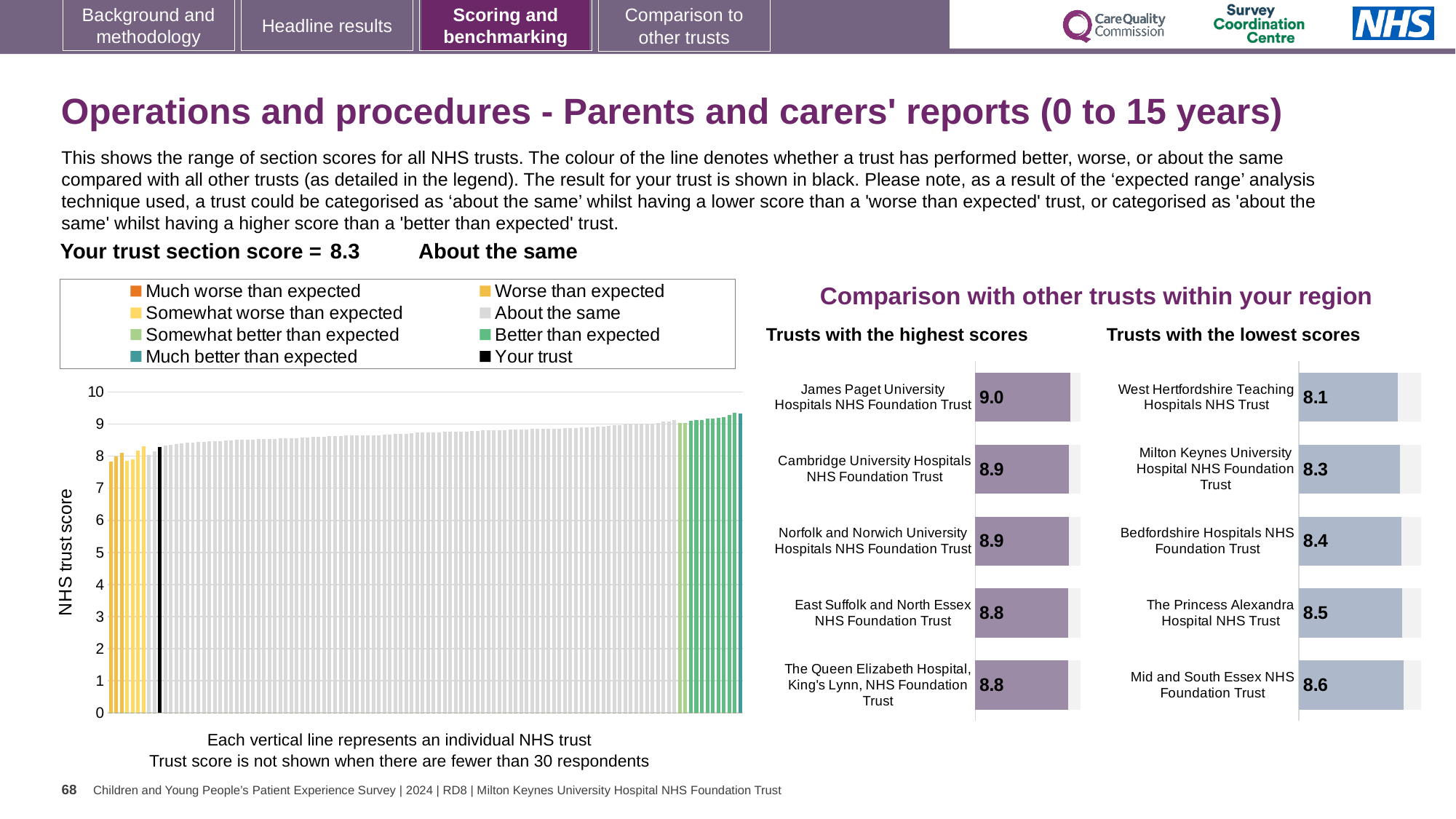
How many entries does the legend of the main chart on the left list? 8 In the 'Trusts with the lowest scores' chart, which trust has the highest score? Mid and South Essex NHS Foundation Trust What is the label on the vertical axis of the main chart on the left? NHS trust score In the 'Trusts with the lowest scores' chart, which trust has the lowest score? West Hertfordshire Teaching Hospitals NHS Trust What is the difference between the score for James Paget University Hospitals NHS Foundation Trust in the highest scores chart and West Hertfordshire Teaching Hospitals NHS Trust in the lowest scores chart? 0.9 Which has the larger score: Cambridge University Hospitals NHS Foundation Trust in the highest scores chart or Bedfordshire Hospitals NHS Foundation Trust in the lowest scores chart? Cambridge University Hospitals NHS Foundation Trust In the 'Trusts with the lowest scores' chart, what is the score for Bedfordshire Hospitals NHS Foundation Trust? 8.4 In the main chart on the left, is the value for the black 'Your trust' bar greater or less than 9? less In the 'Trusts with the highest scores' chart, what is the score for James Paget University Hospitals NHS Foundation Trust? 9.0 In the main chart on the left, do the trust scores rise or fall from left to right? Rise What kind of chart is the main chart on the left showing all NHS trusts? Bar chart How many trusts are listed in the 'Trusts with the highest scores' chart? 5